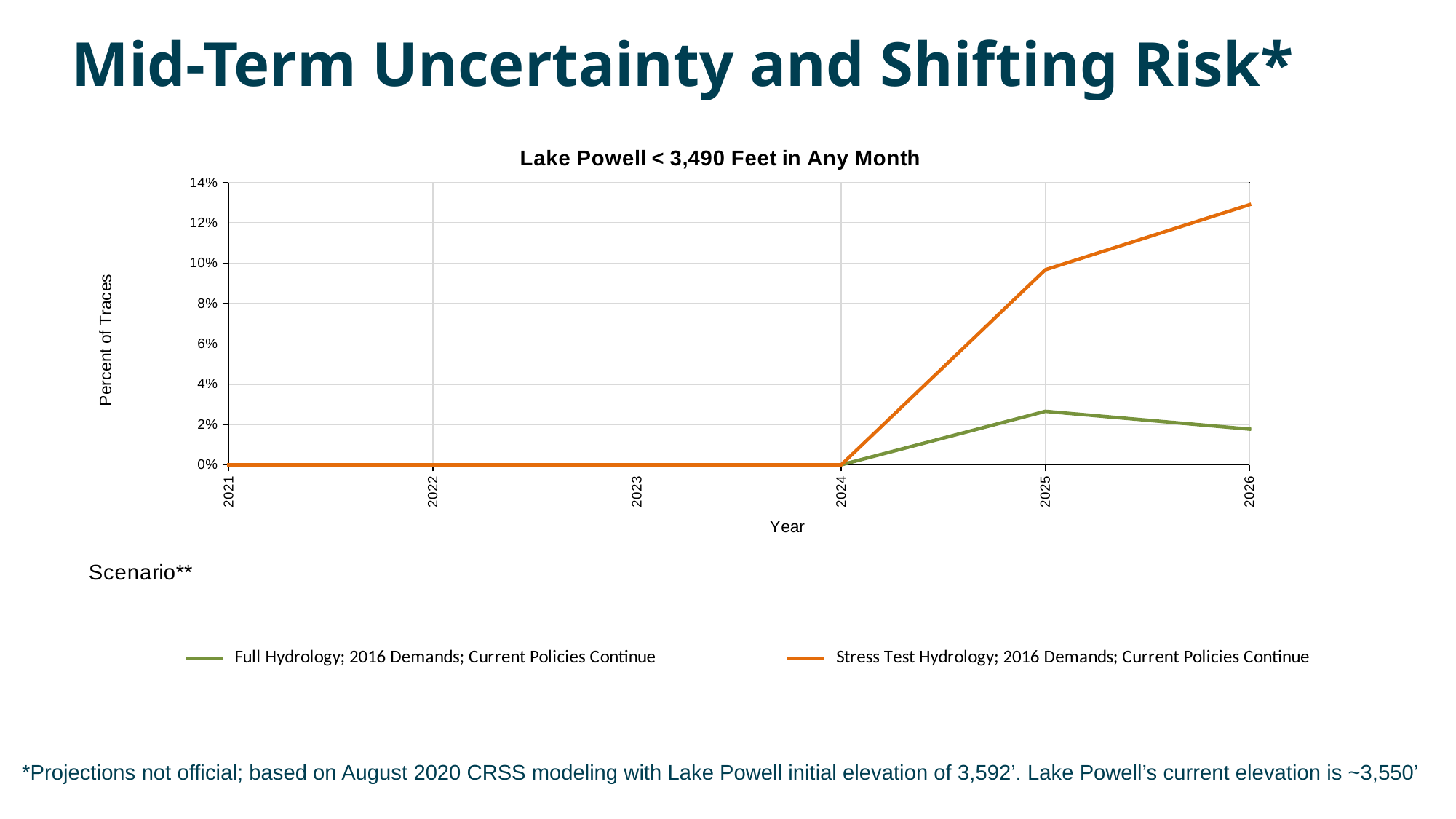
What is the value for the Stress Test Hydrology series in 2023? 0% What is the value for the Full Hydrology series in 2024? 0% What is the title of the chart? Lake Powell < 3,490 Feet in Any Month Is the value for the Stress Test Hydrology series in 2026 greater or less than 12%? greater What kind of chart is shown on the slide? line chart How many series does the legend list? 2 Does the Full Hydrology series rise or fall from 2025 to 2026? fall Does the Stress Test Hydrology series rise or fall from 2024 to 2026? rise Is the value for the Full Hydrology series in 2026 greater or less than 2%? less Which series has the higher value in 2026? Stress Test Hydrology; 2016 Demands; Current Policies Continue Is the value for the Stress Test Hydrology series in 2025 greater or less than 8%? greater How many years are marked along the x axis? 6